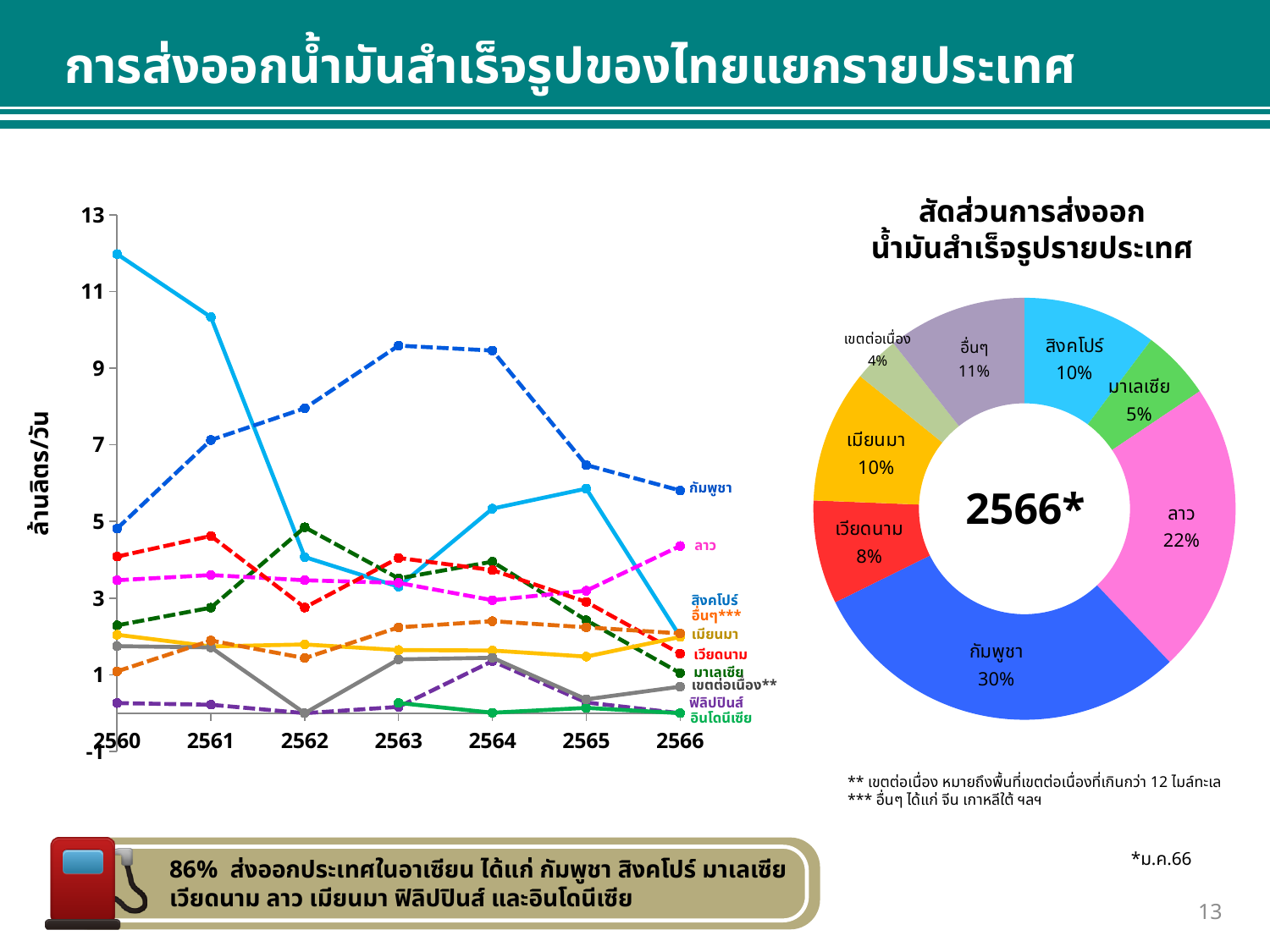
What kind of chart is the chart on the right titled สัดส่วนการส่งออกน้ำมันสำเร็จรูปรายประเทศ? pie chart (donut) In the line chart on the left, is the value for สิงคโปร์ in 2560 greater or less than 11? greater In the pie chart on the right, what is the difference between the shares of ลาว and สิงคโปร์? 12% In the line chart on the left, does the value for สิงคโปร์ rise or fall from 2560 to 2562? fall In the pie chart on the right, which is larger, the share of เมียนมา or the share of มาเลเซีย? เมียนมา In the pie chart on the right, which country has the largest share? กัมพูชา In the pie chart on the right, which slice has the smallest share? เขตต่อเนื่อง In the pie chart on the right, what share does กัมพูชา have? 30% What kind of chart is the chart on the left of the slide? line chart In the line chart on the left, how many years are shown on the x axis? 7 How many slices does the pie chart on the right have? 8 In the pie chart on the right, what share does ลาว have? 22%